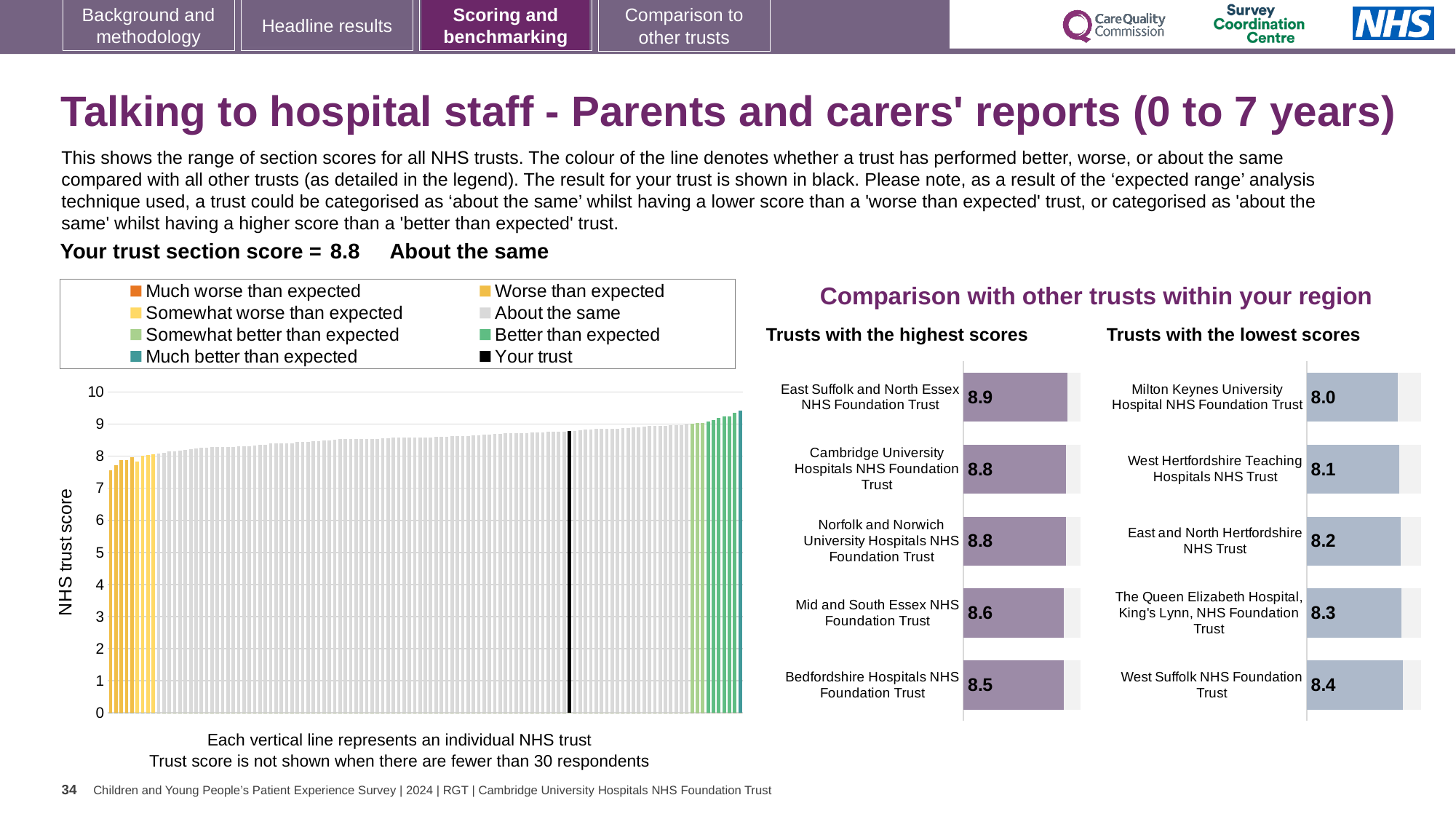
In the NHS trust score chart on the left, what is your trust's section score? 8.8 In the 'Trusts with the highest scores' chart, how many trusts are listed? 5 In the 'Trusts with the lowest scores' chart, what is the score for Milton Keynes University Hospital NHS Foundation Trust? 8.0 What kind of chart is the NHS trust score chart on the left? bar chart In the 'Trusts with the lowest scores' chart, which trust has the lowest score? Milton Keynes University Hospital NHS Foundation Trust In the 'Trusts with the highest scores' chart, what is the difference between the scores of East Suffolk and North Essex NHS Foundation Trust and Bedfordshire Hospitals NHS Foundation Trust? 0.4 In the 'Trusts with the highest scores' chart, which trust has the highest score? East Suffolk and North Essex NHS Foundation Trust In the 'Trusts with the highest scores' chart, what is the score for East Suffolk and North Essex NHS Foundation Trust? 8.9 In the NHS trust score chart on the left, what colour is used to show your trust? black In the NHS trust score chart on the left, how many entries does the legend list? 8 In the 'Trusts with the lowest scores' chart, which has the larger score: West Suffolk NHS Foundation Trust or East and North Hertfordshire NHS Trust? West Suffolk NHS Foundation Trust In the NHS trust score chart on the left, do the trust scores rise or fall from left to right? rise